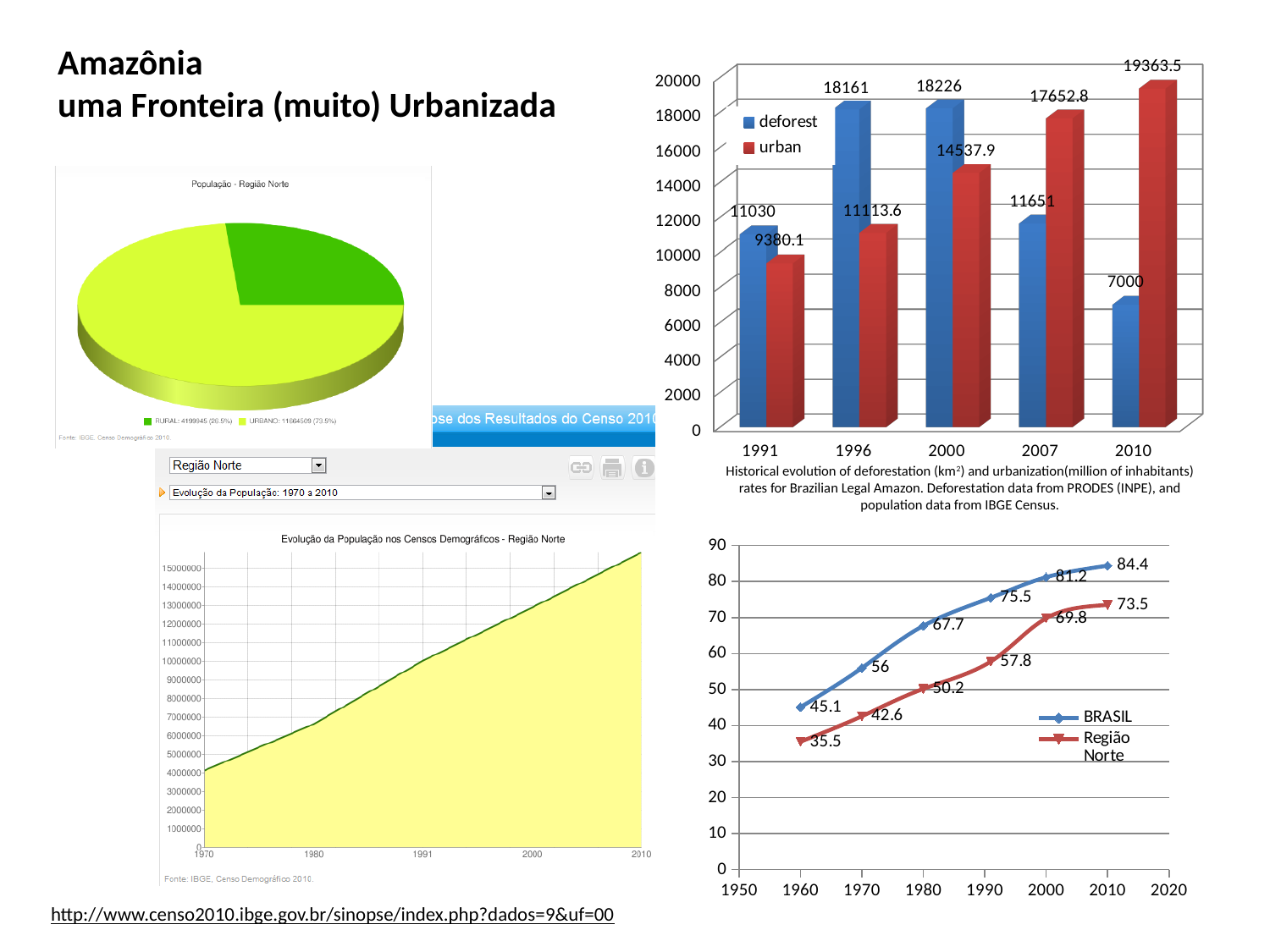
In the bottom-right line chart, what is the BRASIL value for 1980? 67.7 How many series does the legend of the top-right bar chart list? 2 In the pie chart titled 'População - Região Norte', what share of the pie is URBANO? 73.5% In the top-right bar chart, what is the deforest value for 2000? 18226 In the bottom-right line chart, what is the difference between the BRASIL and Região Norte values for 2010? 10.9 In the top-right bar chart, which year has the lowest deforest value? 2010 In the bottom-right line chart, what is the Região Norte value for 2000? 69.8 In the area chart 'Evolução da População nos Censos Demográficos - Região Norte', is the value for 2010 greater or less than 15000000? greater In the top-right bar chart, what is the urban value for 2010? 19363.5 In the top-right bar chart, what is the difference between the deforest and urban values for 1991? 1649.9 In the top-right bar chart, do the urban values rise or fall from 1991 to 2010? rise In the top-right bar chart, which year has the highest urban value? 2010